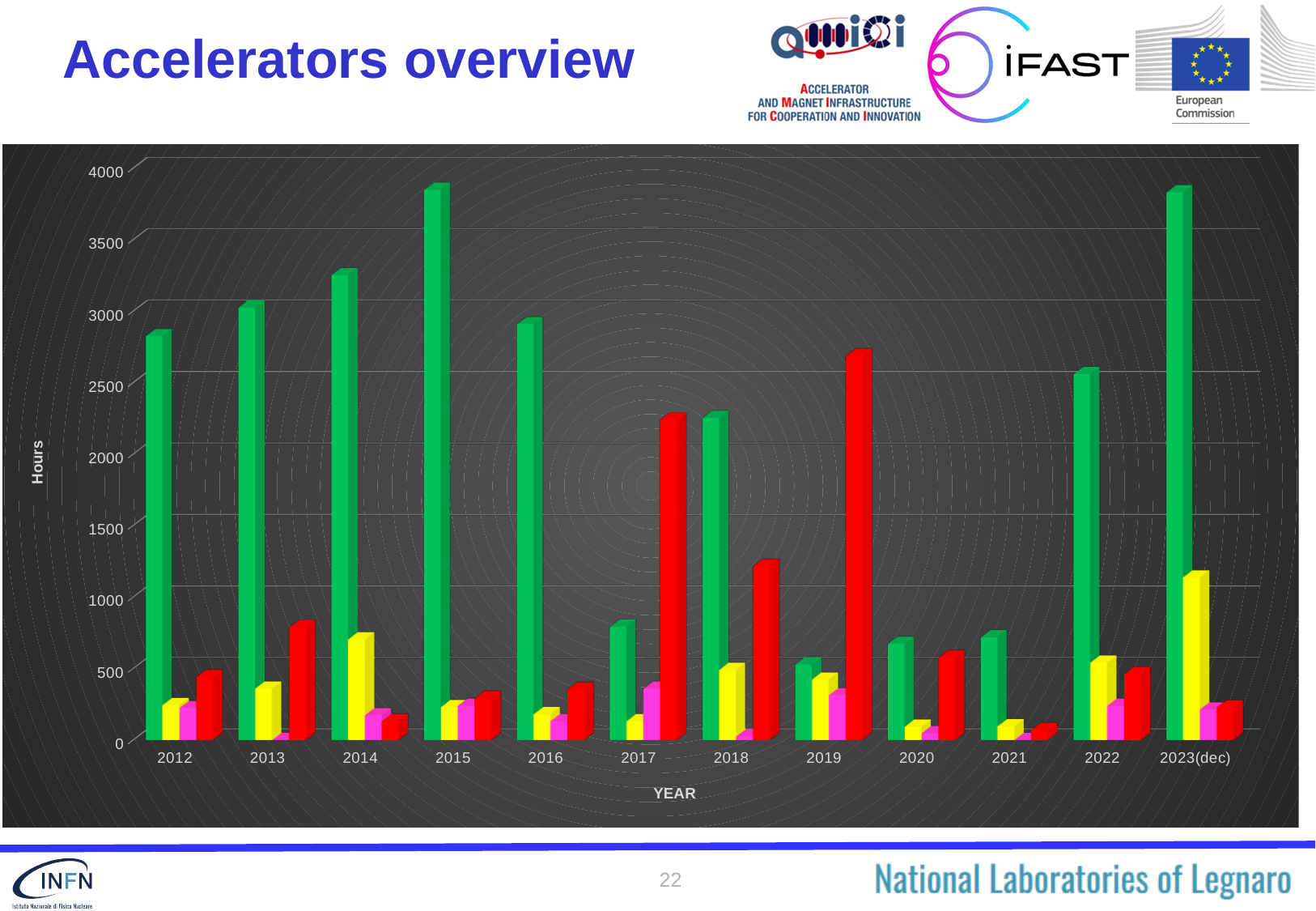
Is the yellow bar for 2023(dec) greater or less than 1000? greater What is the title of the y axis? Hours In which year is the green bar the lowest? 2019 Is the green bar for 2015 greater or less than 3500? greater What kind of chart is shown on the slide? bar chart How many years (categories) are shown on the x axis? 12 In which year is the red bar the highest? 2019 What is the title of the x axis? YEAR For 2018, which is larger, the green bar or the red bar? green bar Is the green bar for 2012 greater or less than 2500? greater